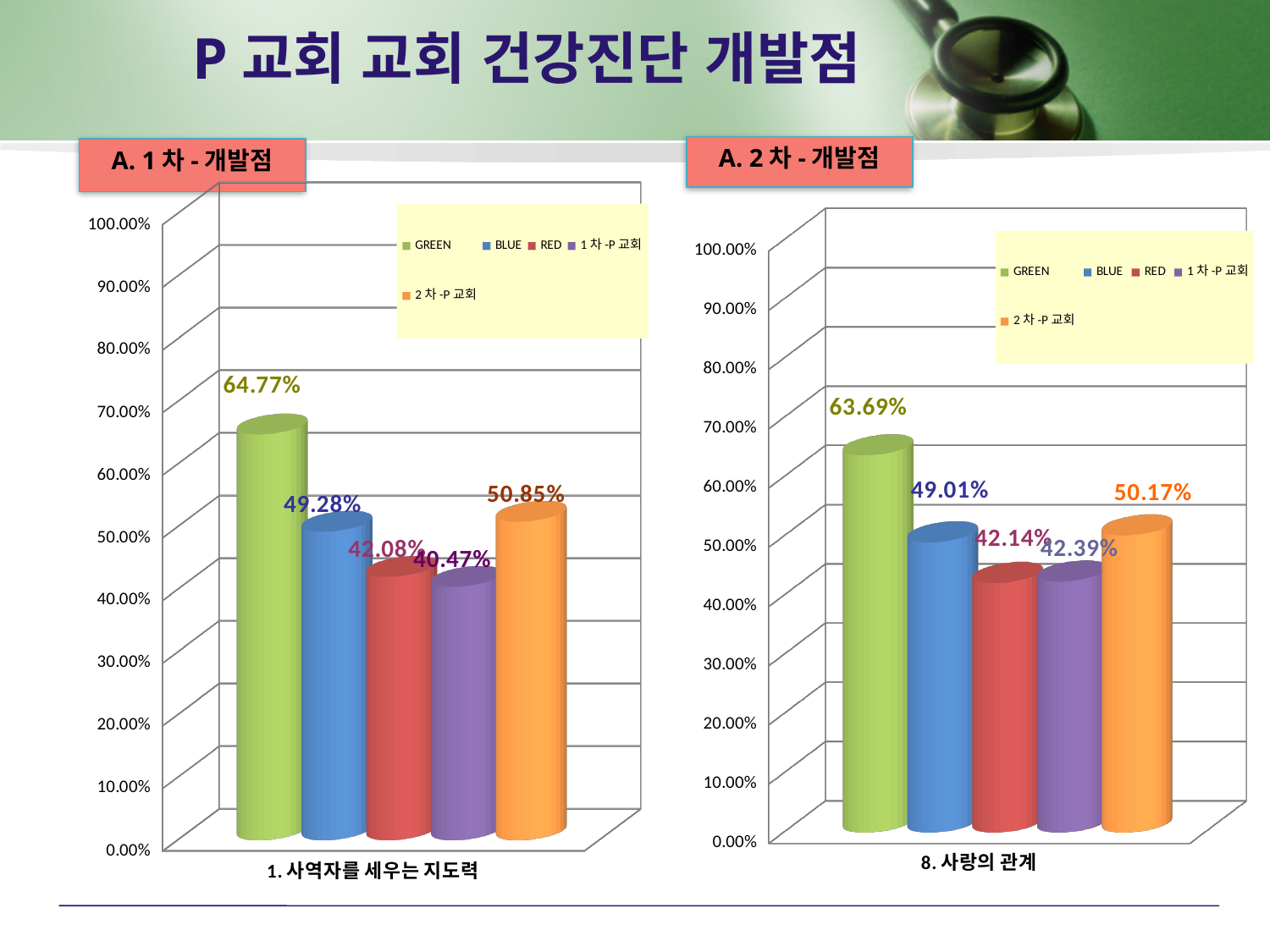
What kind of chart is the left chart (A. 1차 - 개발점)? Bar chart In the left chart (A. 1차 - 개발점), what is the difference between the GREEN value and the BLUE value? 15.49% In the right chart (A. 2차 - 개발점), what is the difference between the GREEN value and the 2차-P 교회 value? 13.52% In the left chart (A. 1차 - 개발점), what is the value for the 2차-P 교회 series? 50.85% In the right chart (A. 2차 - 개발점), what is the value for the 2차-P 교회 series? 50.17% In the left chart (A. 1차 - 개발점), which series has the lowest value? 1차-P 교회 In the right chart (A. 2차 - 개발점), what is the value for the RED series? 42.14% In the right chart (A. 2차 - 개발점), which series has the highest value? GREEN In the left chart (A. 1차 - 개발점), what is the value for the GREEN series? 64.77% What is the category label shown on the x axis of the right chart (A. 2차 - 개발점)? 8. 사랑의 관계 In the left chart (A. 1차 - 개발점), how many series does the legend list? 5 In the right chart (A. 2차 - 개발점), which is larger: the BLUE value or the 2차-P 교회 value? 2차-P 교회